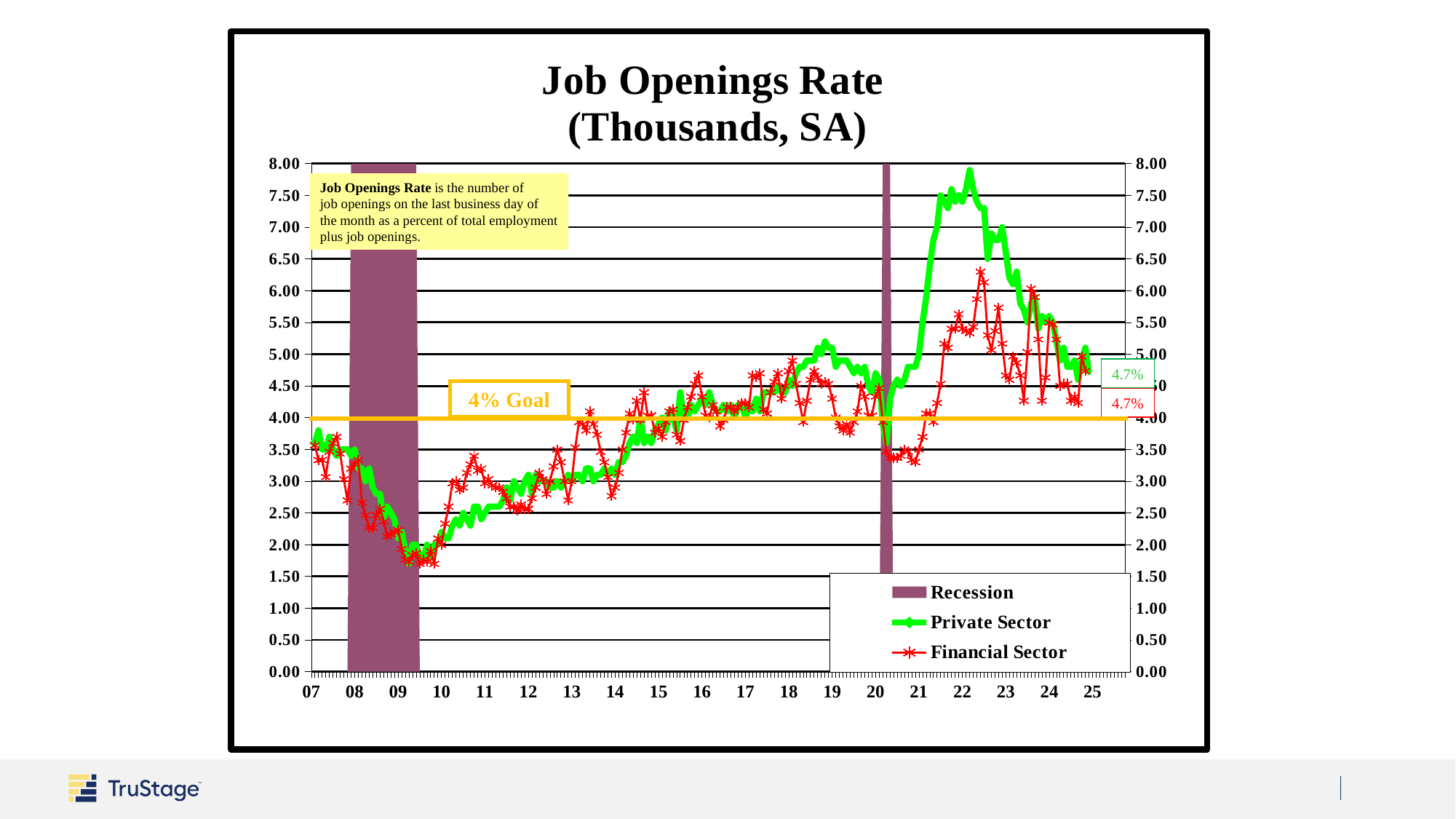
What goal level is marked by the horizontal orange line? 4% Goal Is the peak value of the Private Sector series around 2022 greater or less than 7.50? greater Is the lowest value of the Private Sector series around 2009 greater or less than 2.50? less How many year labels are shown on the x axis? 19 What is the title of the chart? Job Openings Rate (Thousands, SA) What is the latest labelled value for the Private Sector series? 4.7% What kind of chart is shown on the slide? line chart Does the Private Sector series rise or fall from 2022 to 2025? fall Is the peak value of the Financial Sector series around 2022 greater or less than 6.00? greater Which series reached the higher peak value, Private Sector or Financial Sector? Private Sector What is the latest labelled value for the Financial Sector series? 4.7% How many entries does the legend list? 3